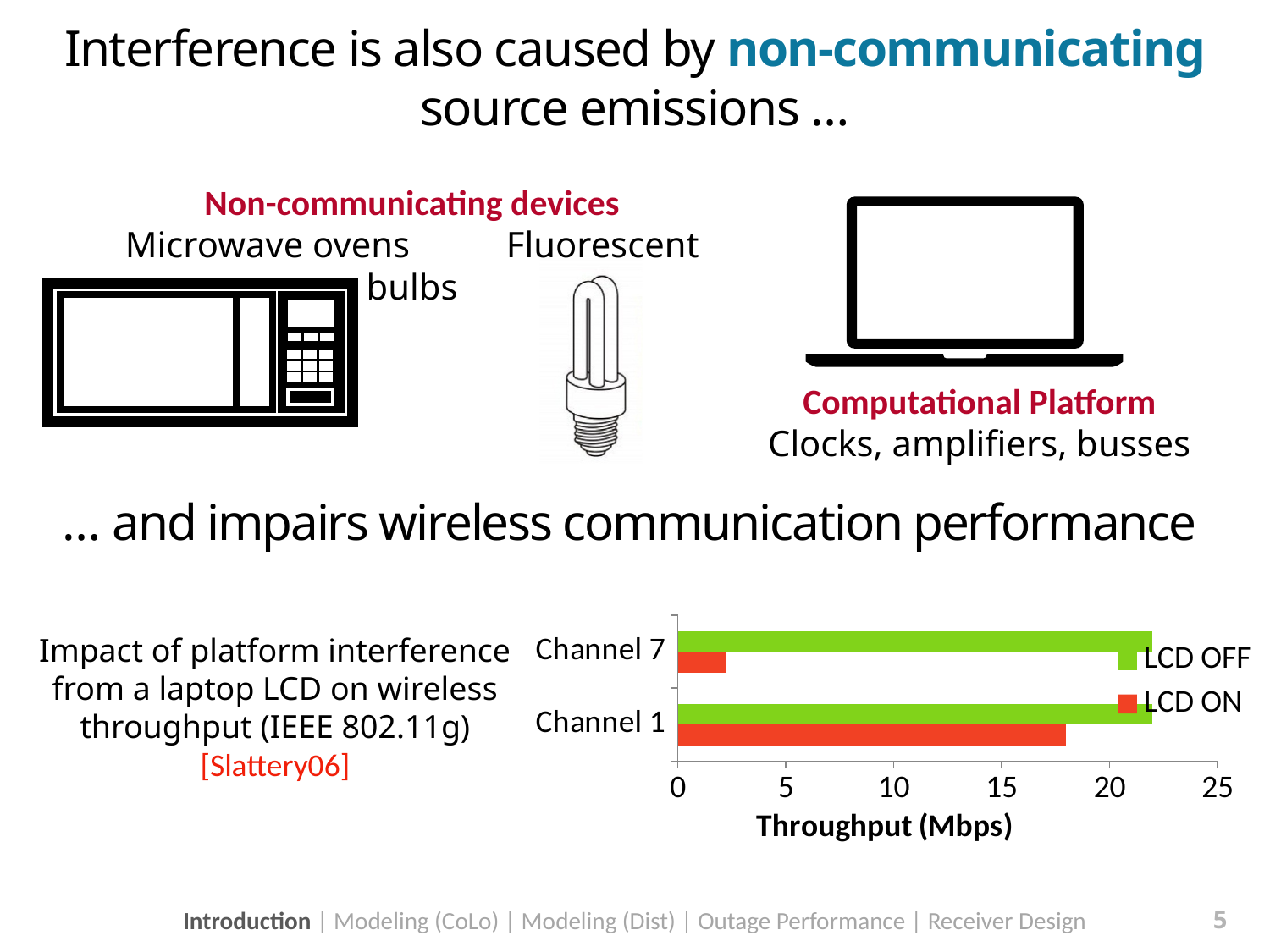
Is the LCD ON throughput for Channel 1 greater or less than 15 Mbps? greater For Channel 1, which series has the larger throughput, LCD OFF or LCD ON? LCD OFF How many channels (categories) are plotted in the chart? 2 Which channel has the higher LCD ON throughput, Channel 1 or Channel 7? Channel 1 Is the LCD ON throughput for Channel 7 greater or less than 5 Mbps? less Is the LCD OFF throughput for Channel 7 greater or less than 20 Mbps? greater What kind of chart is shown on the slide? bar chart Which colour represents the LCD ON series in the chart? red How many series does the chart's legend list? 2 What is the title of the chart's horizontal axis? Throughput (Mbps) Which bar in the chart shows the lowest throughput? Channel 7, LCD ON